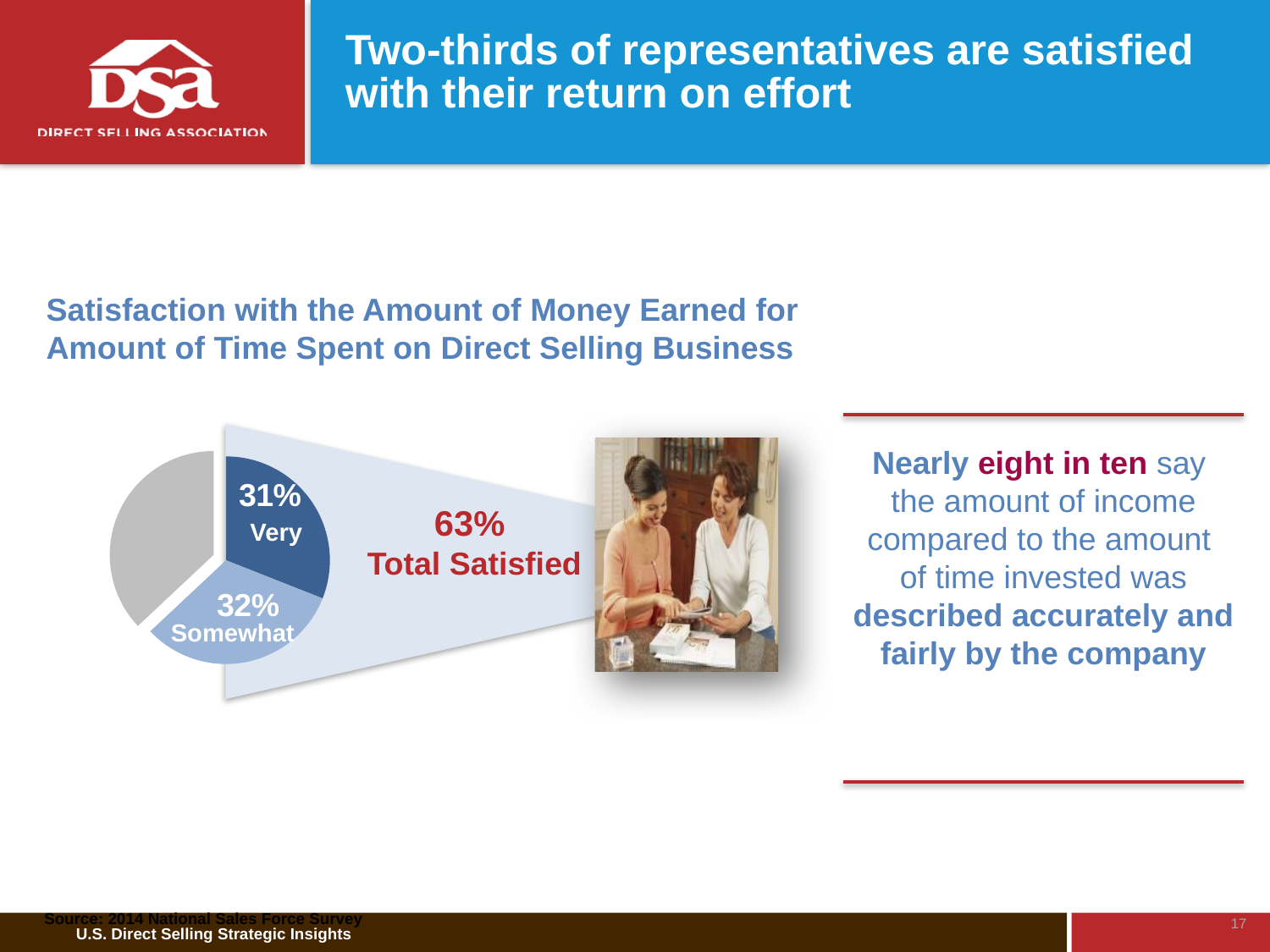
What kind of chart is used to show satisfaction with the amount of money earned? Pie chart What is the combined share of the "Very" and "Somewhat" satisfied slices? 63% What is the "Total Satisfied" percentage shown next to the pie chart? 63% What is the difference in percentage points between the "Somewhat" slice and the "Very" slice? 1 percentage point What percentage of representatives are "Very" satisfied with the amount of money earned for time spent? 31% How many slices of the pie chart have a printed label? 2 What is the source cited for the chart data? 2014 National Sales Force Survey What is the title of the pie chart? Satisfaction with the Amount of Money Earned for Amount of Time Spent on Direct Selling Business What percentage of representatives are "Somewhat" satisfied with the amount of money earned for time spent? 32%